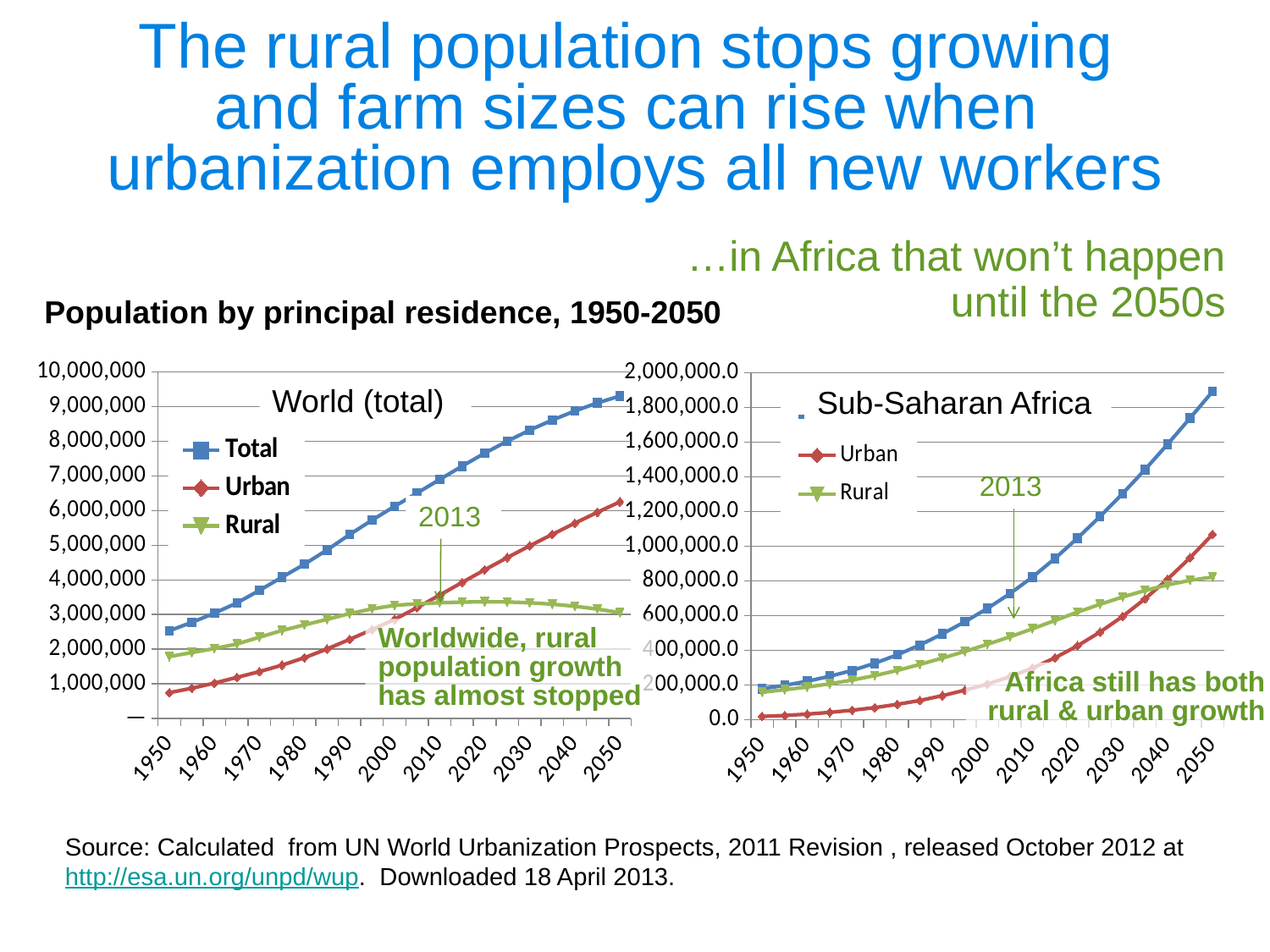
In the World (total) chart, does the Total series rise or fall from 1950 to 2050? rise In the Sub-Saharan Africa chart, which series is higher in 1950, Urban or Rural? Rural In the Sub-Saharan Africa chart, is the Urban value for 2050 greater or less than 1,000,000.0? greater What kind of chart is the World (total) chart? line chart In the World (total) chart, is the Urban value for 1950 greater or less than 1,000,000? less How many year labels are shown on the x axis of the Sub-Saharan Africa chart? 11 In the Sub-Saharan Africa chart, is the Urban value for 1950 greater or less than 200,000.0? less In the World (total) chart, which series has the highest value in 2050? Total How many series does the legend of the World (total) chart list? 3 In the World (total) chart, which series is higher in 2050, Urban or Rural? Urban What is the title printed above the two charts? Population by principal residence, 1950-2050